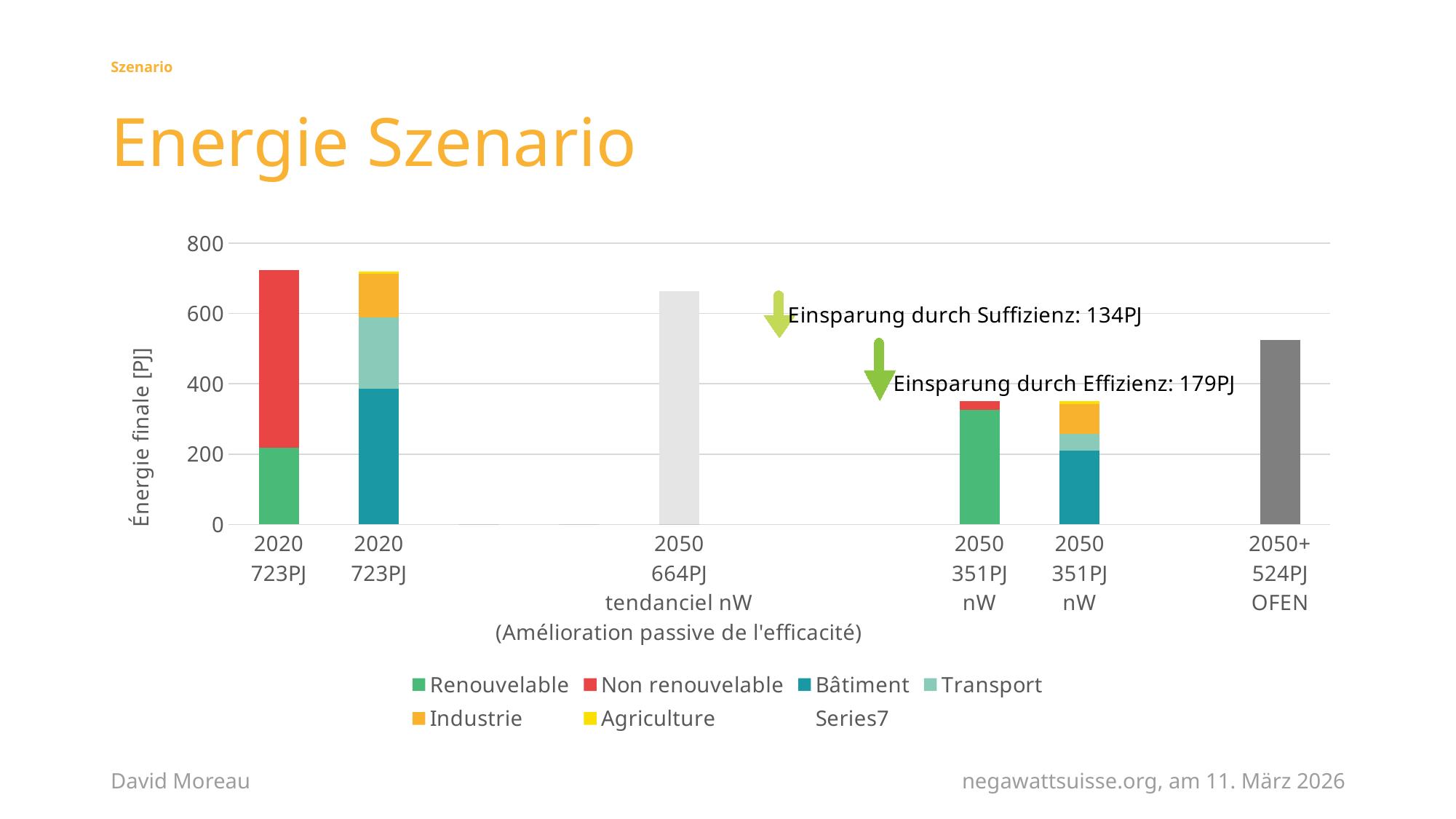
What is the total of the 2020 stacked bar? 723PJ What is the total of the 2050 nW stacked bar? 351PJ What is the value for the 2050+ OFEN bar? 524PJ What kind of chart is shown on the slide? bar chart What is the total for the 2050 tendanciel nW bar? 664PJ What is the y-axis label of the chart? Énergie finale [PJ] Which category has the lowest total? 2050 nW (351PJ) Which is larger, the 2050+ OFEN bar or the 2050 nW bar? 2050+ OFEN How many series does the legend list? 7 What is the difference between the 2020 total and the 2050 nW total? 372PJ Is the Renouvelable segment in the 2020 bar greater or less than 400? less Which category has the highest total? 2020 (723PJ)